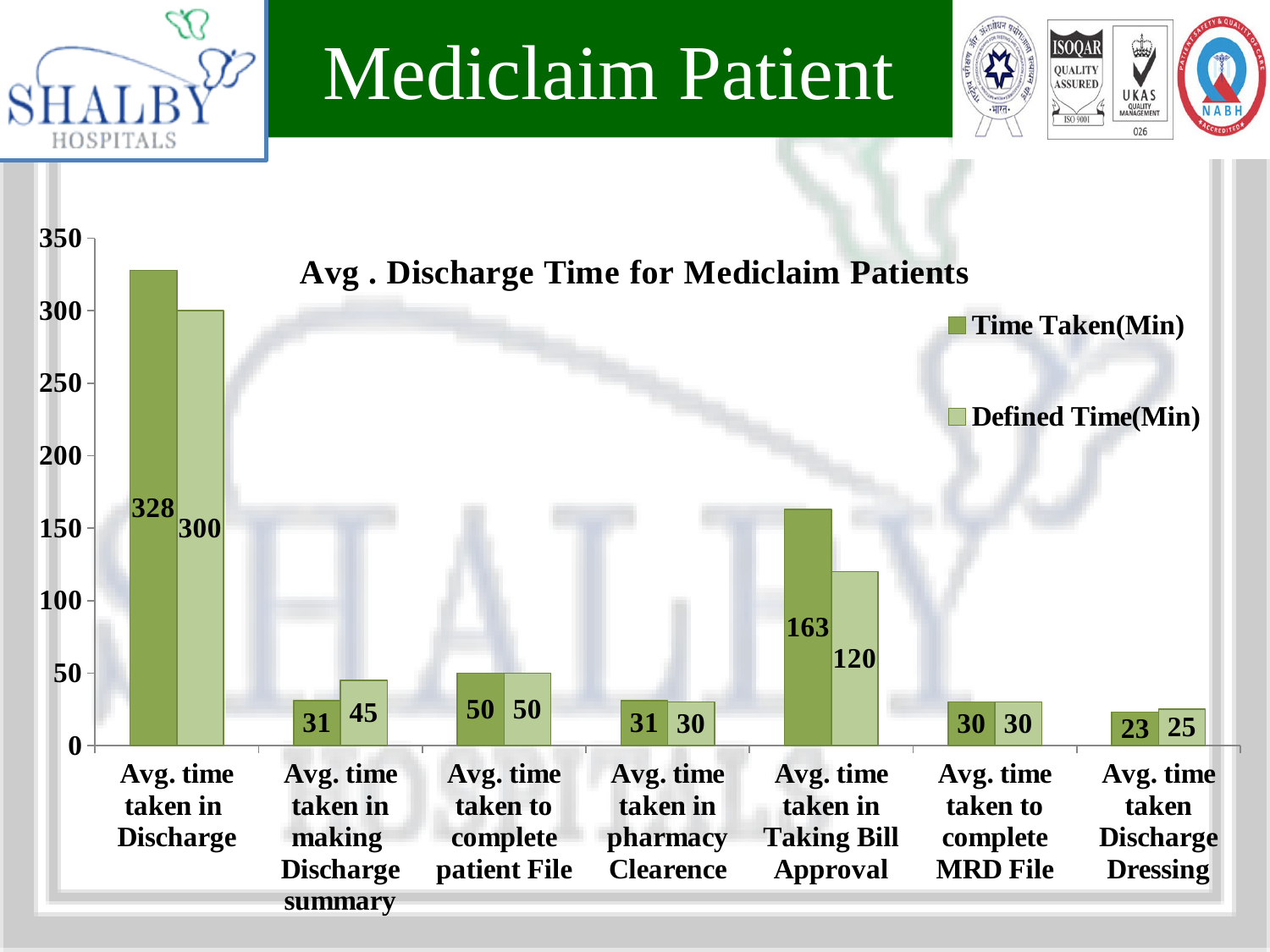
Which category has the highest Time Taken(Min)? Avg. time taken in Discharge How many series does the legend list? 2 What is the Time Taken(Min) for Avg. time taken Discharge Dressing? 23 What is the Time Taken(Min) for Avg. time taken in Discharge? 328 What kind of chart is shown on the slide? Bar chart What is the difference between Time Taken(Min) and Defined Time(Min) for Avg. time taken in Taking Bill Approval? 43 What is the Defined Time(Min) for Avg. time taken in Taking Bill Approval? 120 Is the Time Taken(Min) for Avg. time taken in Discharge greater or less than 300? greater How many categories are shown on the x axis? 7 For Avg. time taken in making Discharge summary, which is larger: Time Taken(Min) or Defined Time(Min)? Defined Time(Min) What is the title of the chart? Avg . Discharge Time for Mediclaim Patients Which category has the lowest Defined Time(Min)? Avg. time taken Discharge Dressing